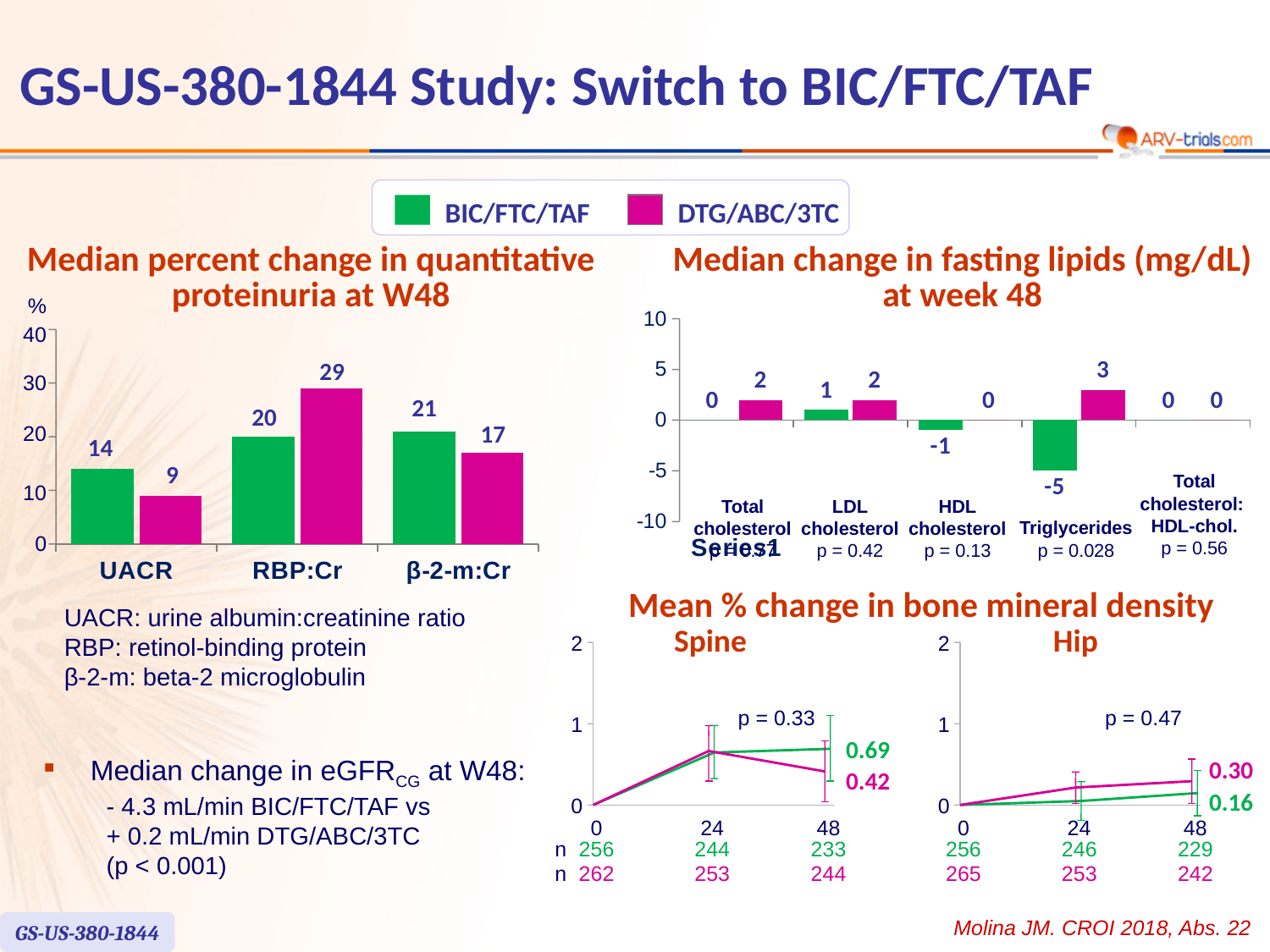
In the Spine chart of 'Mean % change in bone mineral density', what is the value for BIC/FTC/TAF at week 48? 0.69 In the 'Median change in fasting lipids (mg/dL) at week 48' chart, what is the value for BIC/FTC/TAF for Triglycerides? -5 In the Hip chart of 'Mean % change in bone mineral density', what is the value for DTG/ABC/3TC at week 48? 0.30 In the 'Median change in fasting lipids (mg/dL) at week 48' chart, what is the value for DTG/ABC/3TC for LDL cholesterol? 2 In the 'Median change in fasting lipids (mg/dL) at week 48' chart, is the DTG/ABC/3TC value for Triglycerides larger or smaller than the BIC/FTC/TAF value? larger In the 'Median percent change in quantitative proteinuria at W48' chart, what is the difference between the DTG/ABC/3TC and BIC/FTC/TAF values for β-2-m:Cr? 4 In the 'Median change in fasting lipids (mg/dL) at week 48' chart, which category has the lowest BIC/FTC/TAF value? Triglycerides In the 'Median percent change in quantitative proteinuria at W48' chart, which category has the highest DTG/ABC/3TC value? RBP:Cr What kind of chart is the 'Median percent change in quantitative proteinuria at W48' chart? bar chart In the 'Median percent change in quantitative proteinuria at W48' chart, how many categories are shown on the x axis? 3 In the 'Median percent change in quantitative proteinuria at W48' chart, what is the value for DTG/ABC/3TC for RBP:Cr? 29 In the 'Median percent change in quantitative proteinuria at W48' chart, what is the value for BIC/FTC/TAF for UACR? 14